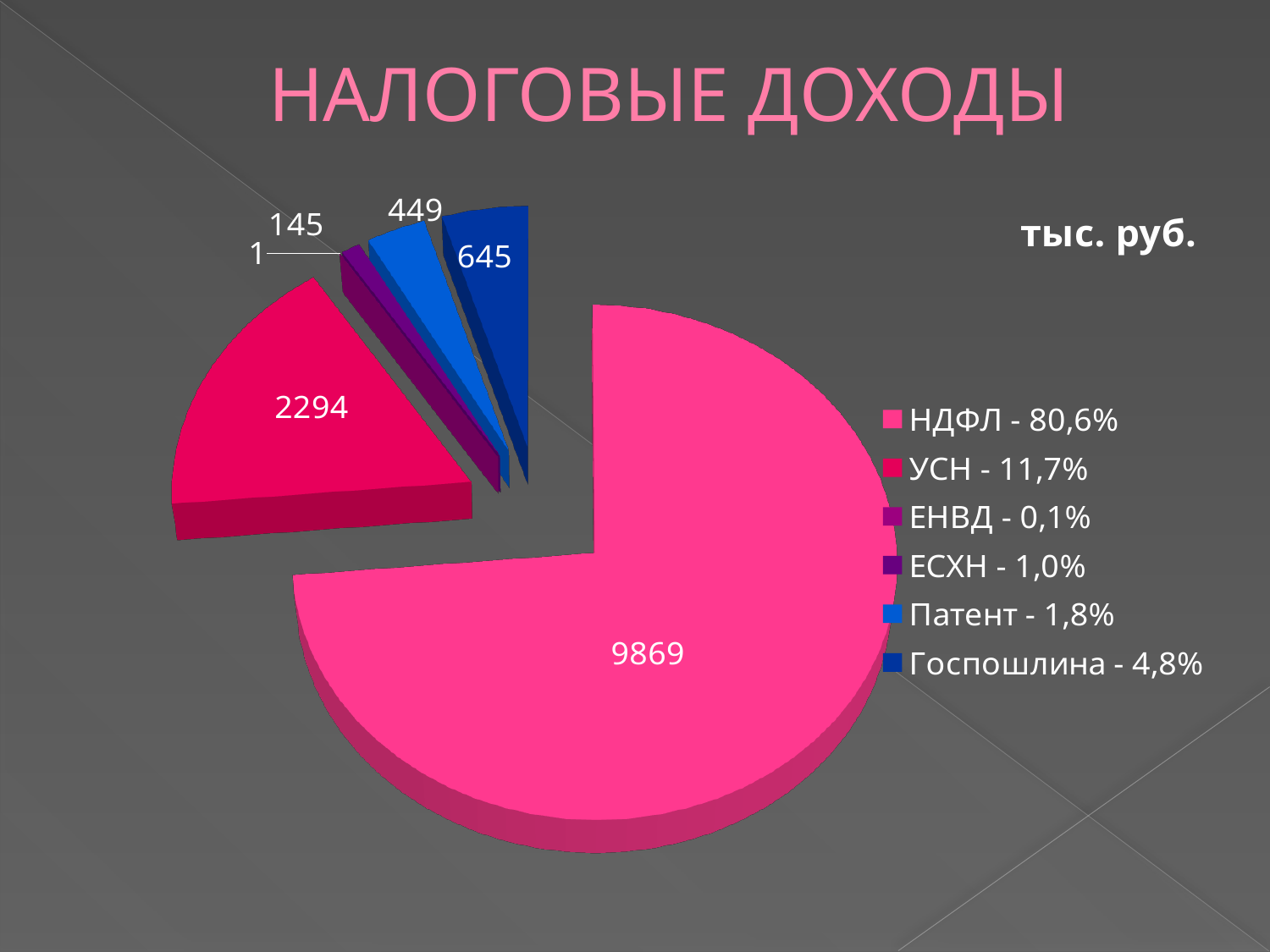
Which is larger, the value for Госпошлина or the value for Патент? Госпошлина What is the value for Патент? 449 How many categories does the pie chart have? 6 Which category has the largest slice? НДФЛ What is the difference between the values for НДФЛ and УСН? 7575 What is the value for УСН? 2294 What kind of chart is shown on the slide? pie chart What is the value for Госпошлина? 645 What unit is stated for the values on the slide? тыс. руб. What share of the pie does УСН represent, according to the legend? 11,7% What is the value for НДФЛ? 9869 Which category has the smallest slice? ЕНВД